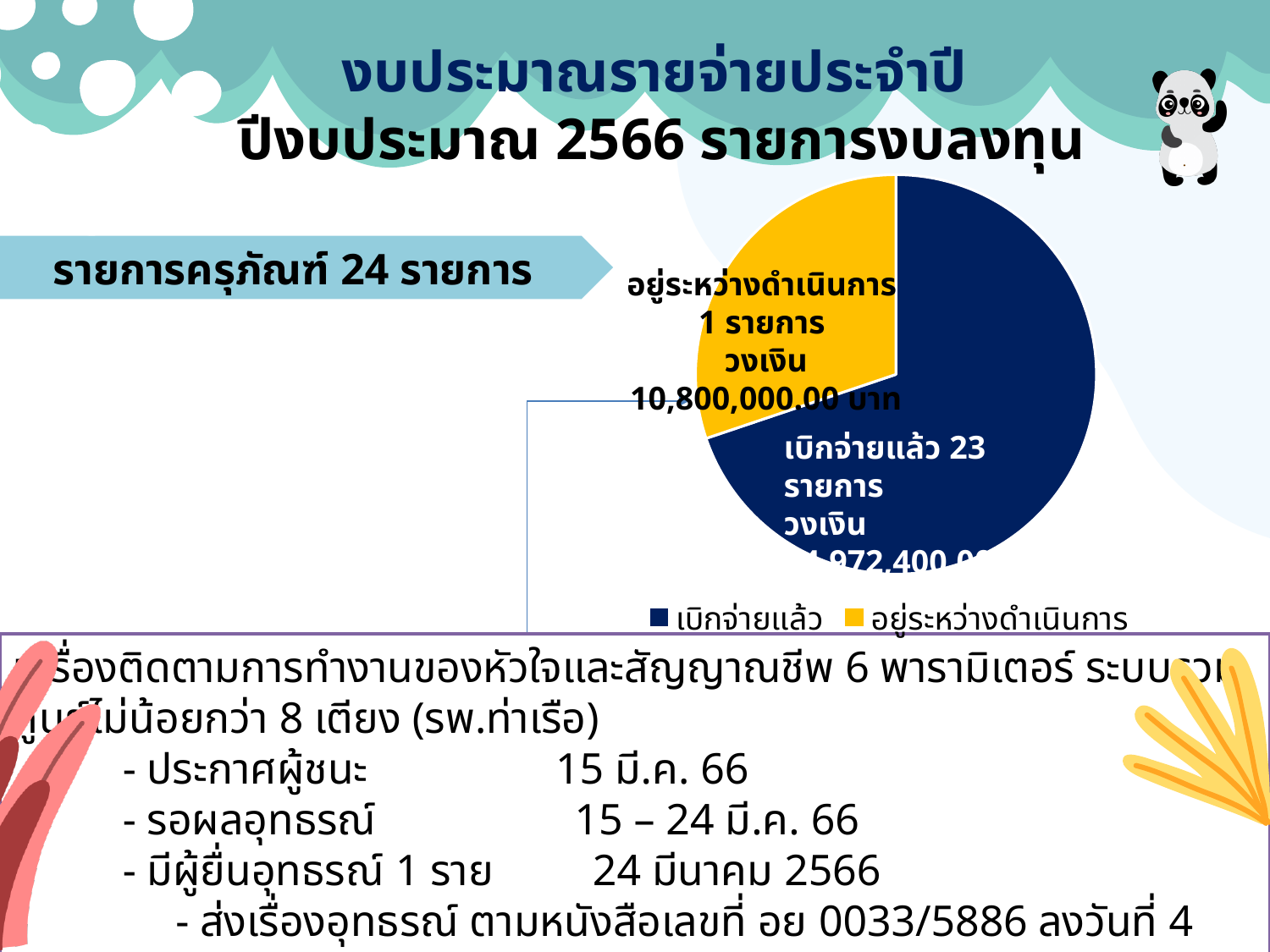
How many items (รายการ) are labelled as อยู่ระหว่างดำเนินการ in the pie chart? 1 รายการ What colour represents อยู่ระหว่างดำเนินการ in the pie chart? yellow What is the amount (วงเงิน) shown for the อยู่ระหว่างดำเนินการ slice? 10,800,000.00 บาท Which slice is larger, เบิกจ่ายแล้ว or อยู่ระหว่างดำเนินการ? เบิกจ่ายแล้ว How many entries does the legend of the pie chart list? 2 How many items (รายการ) are labelled as เบิกจ่ายแล้ว in the pie chart? 23 รายการ Which slice of the pie chart is the largest? เบิกจ่ายแล้ว How many more items are เบิกจ่ายแล้ว than อยู่ระหว่างดำเนินการ? 22 Which slice of the pie chart is the smallest? อยู่ระหว่างดำเนินการ What colour represents เบิกจ่ายแล้ว in the pie chart? dark blue How many slices does the pie chart have? 2 What kind of chart is shown on the slide? pie chart